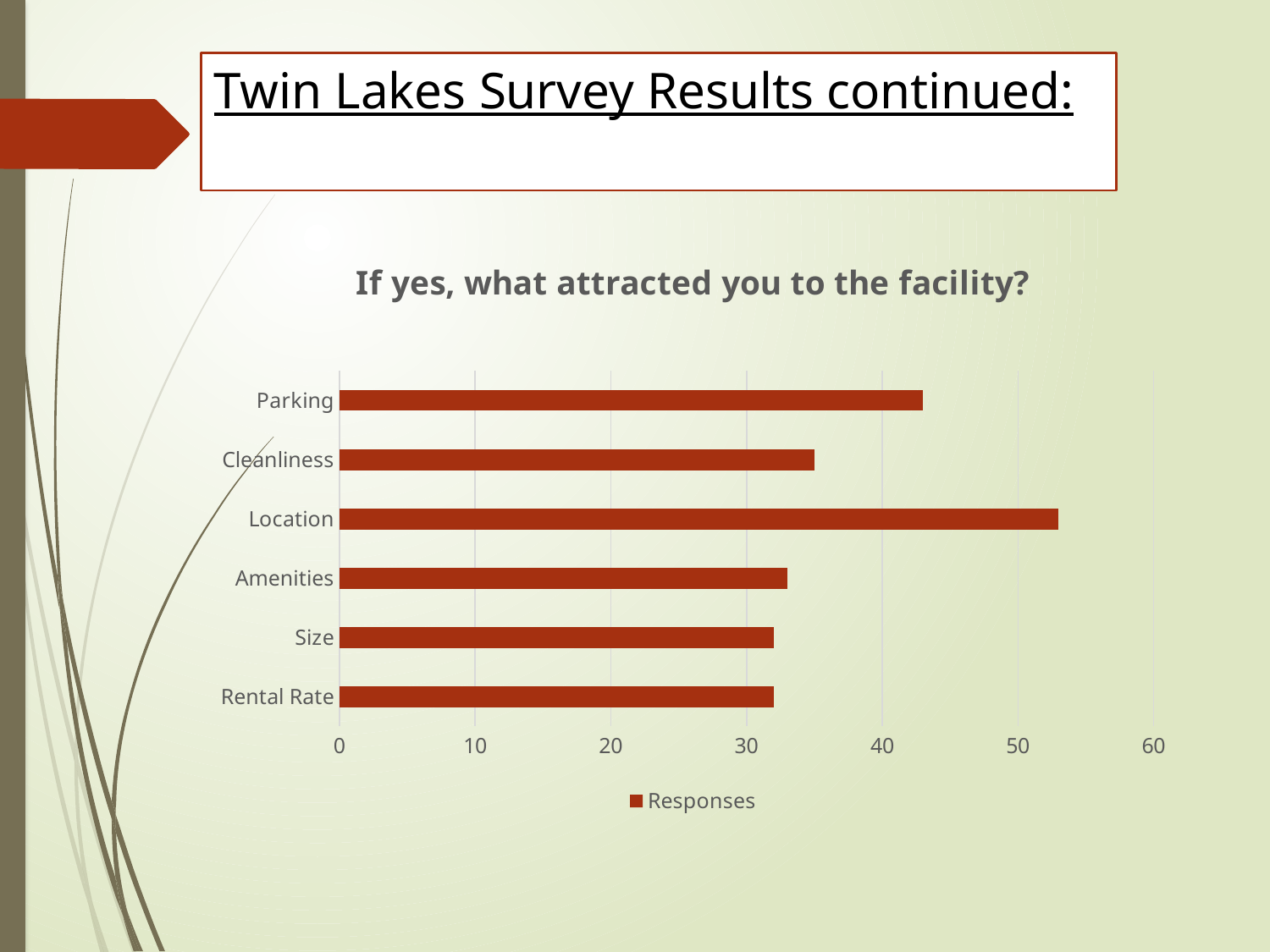
How many categories are shown on the chart? 6 Which has more responses, Parking or Cleanliness? Parking Is the value for Cleanliness greater or less than 40? less Which has more responses, Location or Parking? Location Is the value for Location greater or less than 50? greater Is the value for Amenities greater or less than 30? greater What is the title of the chart? If yes, what attracted you to the facility? What is the name of the series shown in the legend? Responses What kind of chart is shown on the slide? bar chart Which category has the highest number of responses? Location How many series does the legend list? 1